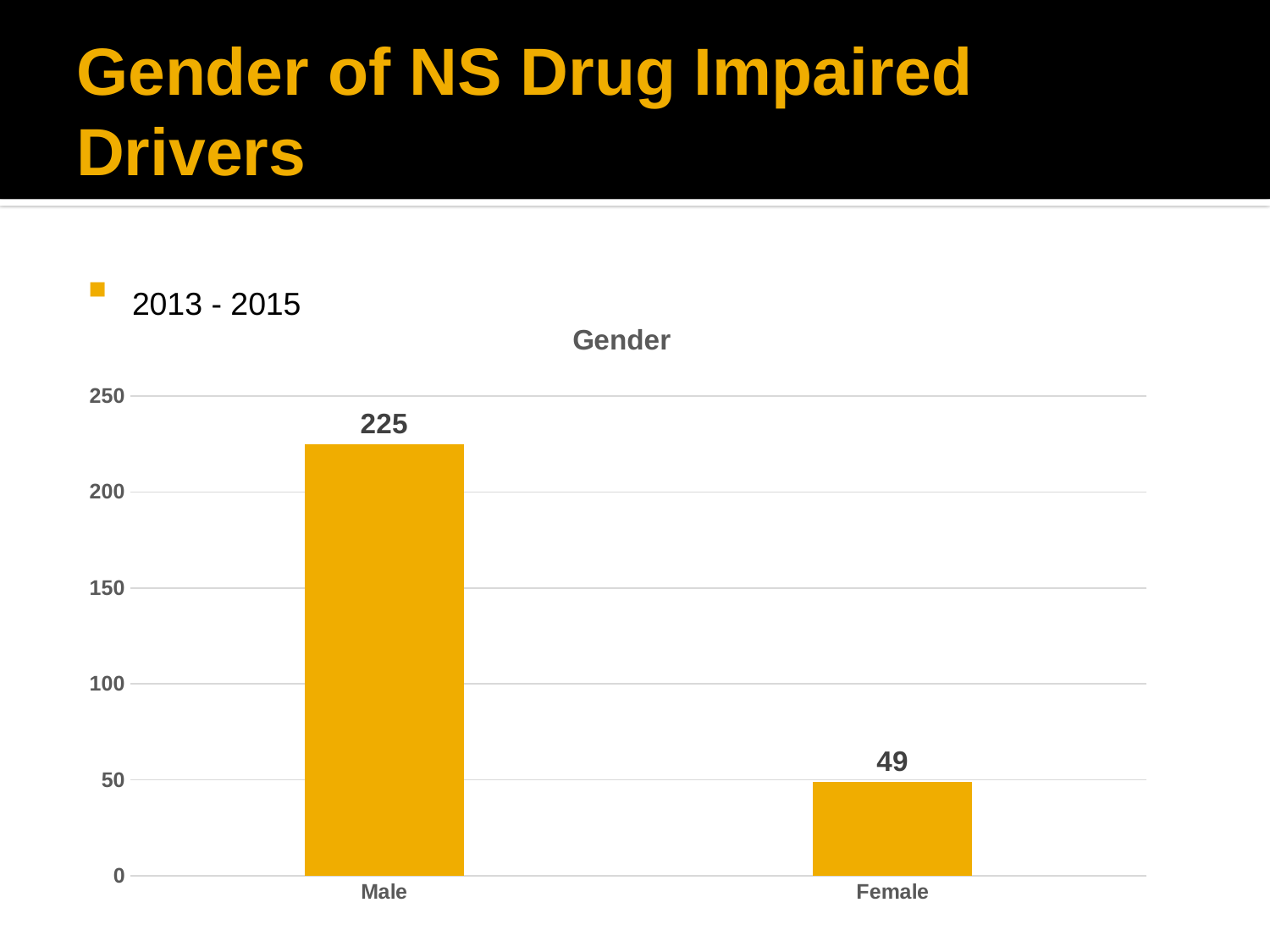
What is the value for Female? 49 Is the value for Male greater or less than 200? greater What is the value for Male? 225 What is the highest value shown on the y axis? 250 What is the title of the chart? Gender How many categories are shown on the x axis? 2 Is the value for Female greater or less than 100? less What kind of chart is shown on the slide? bar chart Which category has the highest value? Male What is the difference between the values for Male and Female? 176 Which is larger, the value for Male or the value for Female? Male Which category has the lowest value? Female